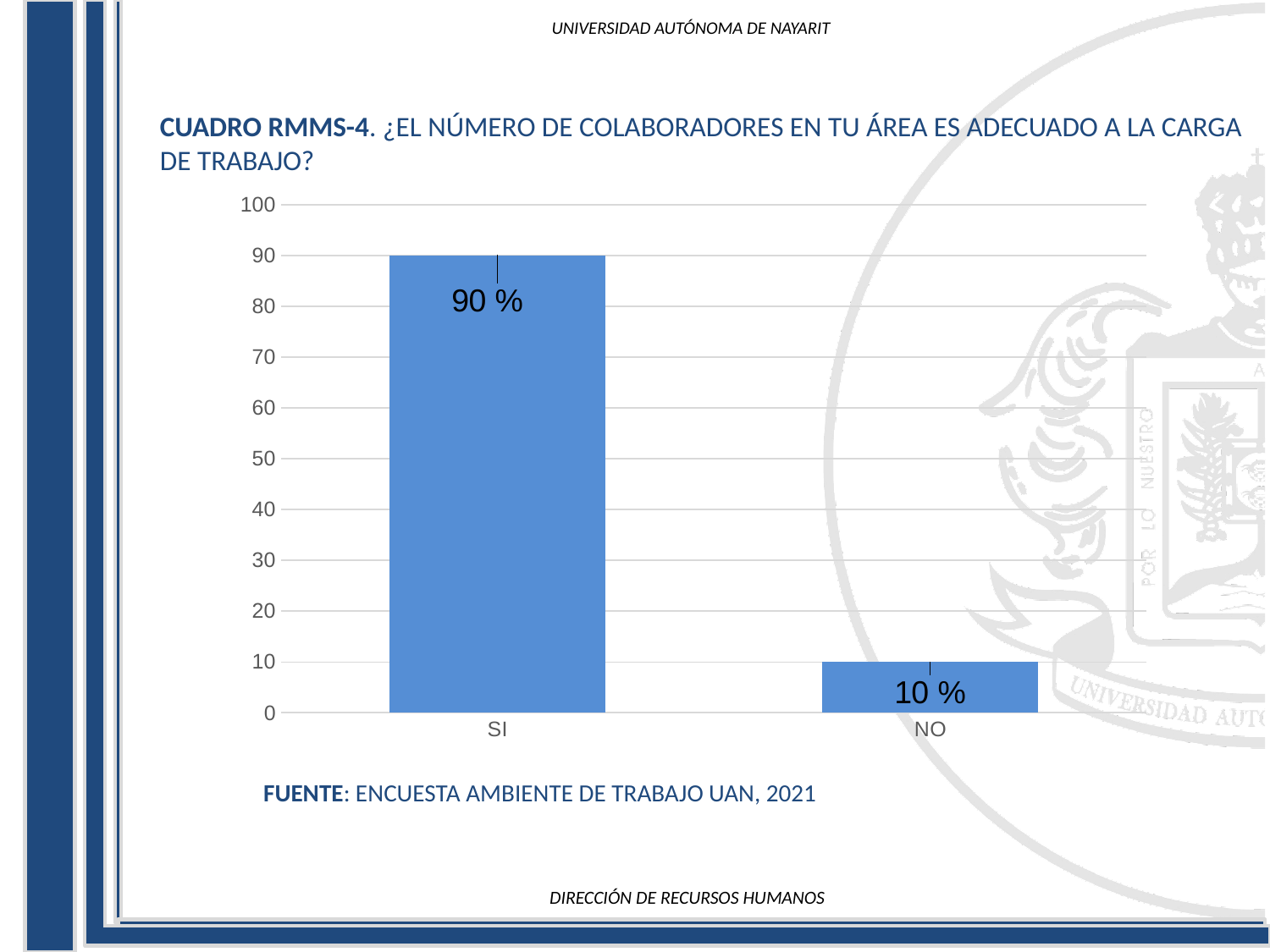
Is the value for NO greater or less than 20? less What is the difference between the values for SI and NO? 80 % What is the value for NO? 10 % Which is larger, the value for SI or the value for NO? SI How many categories are shown on the x axis? 2 What is the source cited below the chart? ENCUESTA AMBIENTE DE TRABAJO UAN, 2021 What is the total of the values for SI and NO? 100 % Which category has the lowest value? NO Is the value for SI greater or less than 50? greater What is the value for SI? 90 % What kind of chart is shown on the slide? bar chart Which category has the highest value? SI